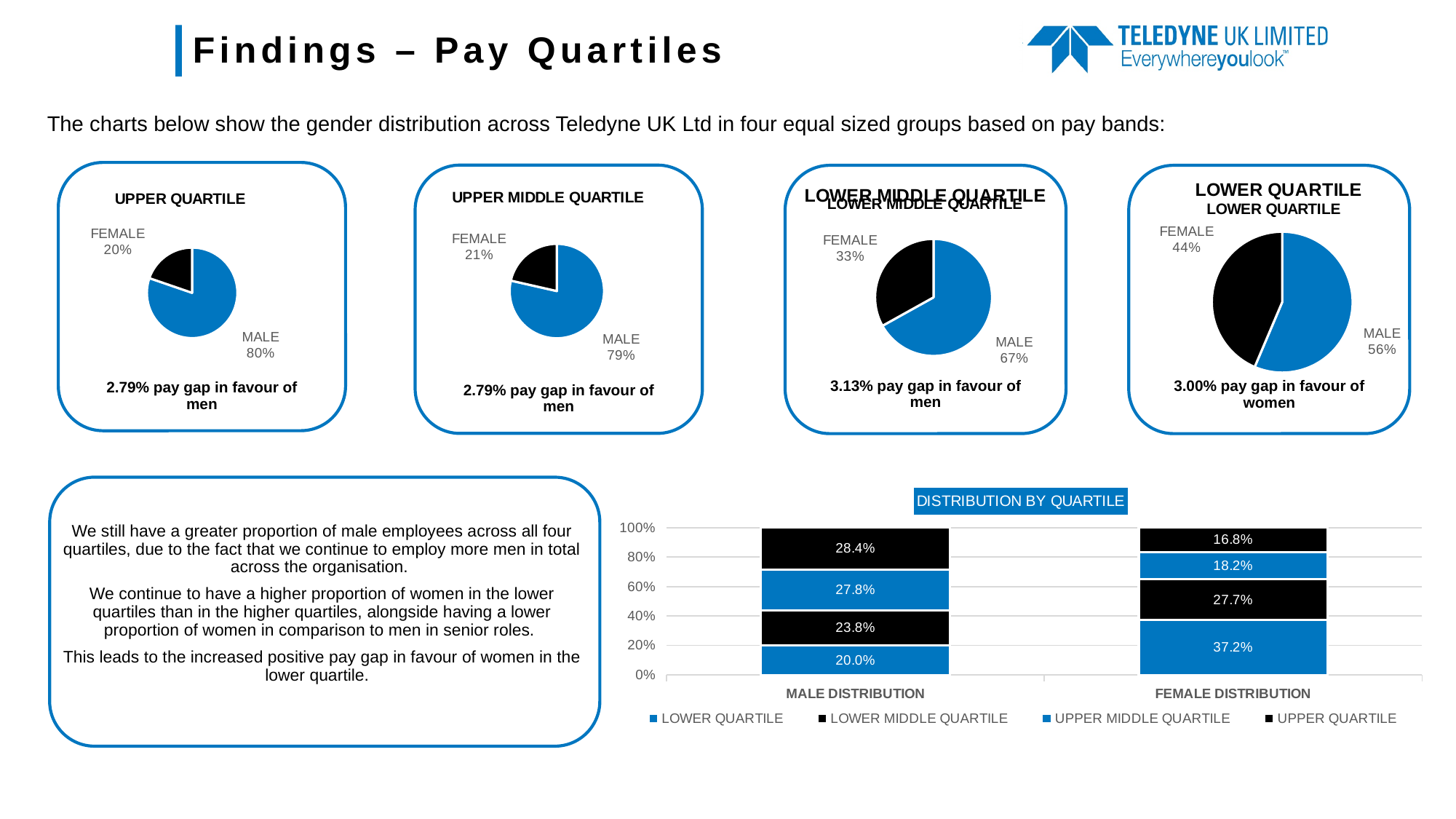
In the Distribution by Quartile chart, what is the difference between the Lower Quartile and Upper Quartile values for Female Distribution? 20.4% What kind of chart is the Distribution by Quartile chart? Stacked bar chart In the Lower Quartile pie chart, what share is male? 56% In the Lower Middle Quartile pie chart, what share is female? 33% In the Distribution by Quartile chart, what is the Upper Quartile value for Male Distribution? 28.4% In the Upper Quartile pie chart, what share is female? 20% In the Distribution by Quartile chart, which is larger: the Upper Middle Quartile value for Male Distribution or for Female Distribution? Male Distribution In the Distribution by Quartile chart, how many categories are shown on the x axis? 2 In the Upper Middle Quartile pie chart, what is the difference between the male and female shares? 58% In the Distribution by Quartile chart, how many series does the legend list? 4 Which of the four quartile pie charts has the largest female share? Lower Quartile In the Distribution by Quartile chart, what is the Lower Quartile value for Female Distribution? 37.2%